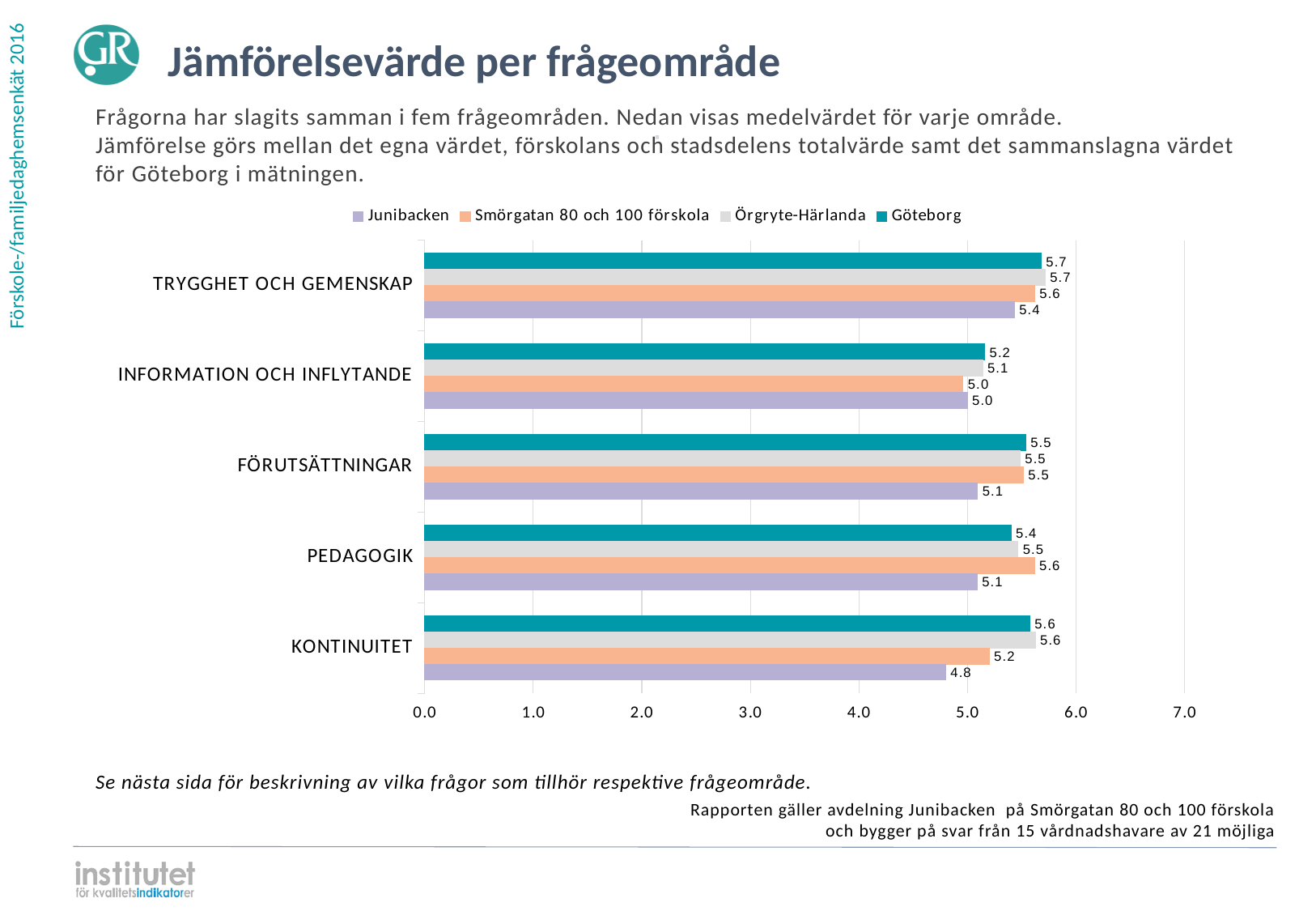
What is the value for Junibacken in KONTINUITET? 4.8 Is the value for Junibacken in KONTINUITET greater or less than 5.0? less What is the value for Örgryte-Härlanda in INFORMATION OCH INFLYTANDE? 5.1 How many question areas (categories) are shown on the chart? 5 Which is larger in PEDAGOGIK: the value for Smörgatan 80 och 100 förskola or the value for Junibacken? Smörgatan 80 och 100 förskola What is the difference between the Göteborg value and the Junibacken value in KONTINUITET? 0.8 What kind of chart is shown on the slide? Bar chart What is the value for Göteborg in TRYGGHET OCH GEMENSKAP? 5.7 How many series does the legend list? 4 In which category does Junibacken have its lowest value? KONTINUITET What is the value for Smörgatan 80 och 100 förskola in PEDAGOGIK? 5.6 In which category does Junibacken have its highest value? TRYGGHET OCH GEMENSKAP